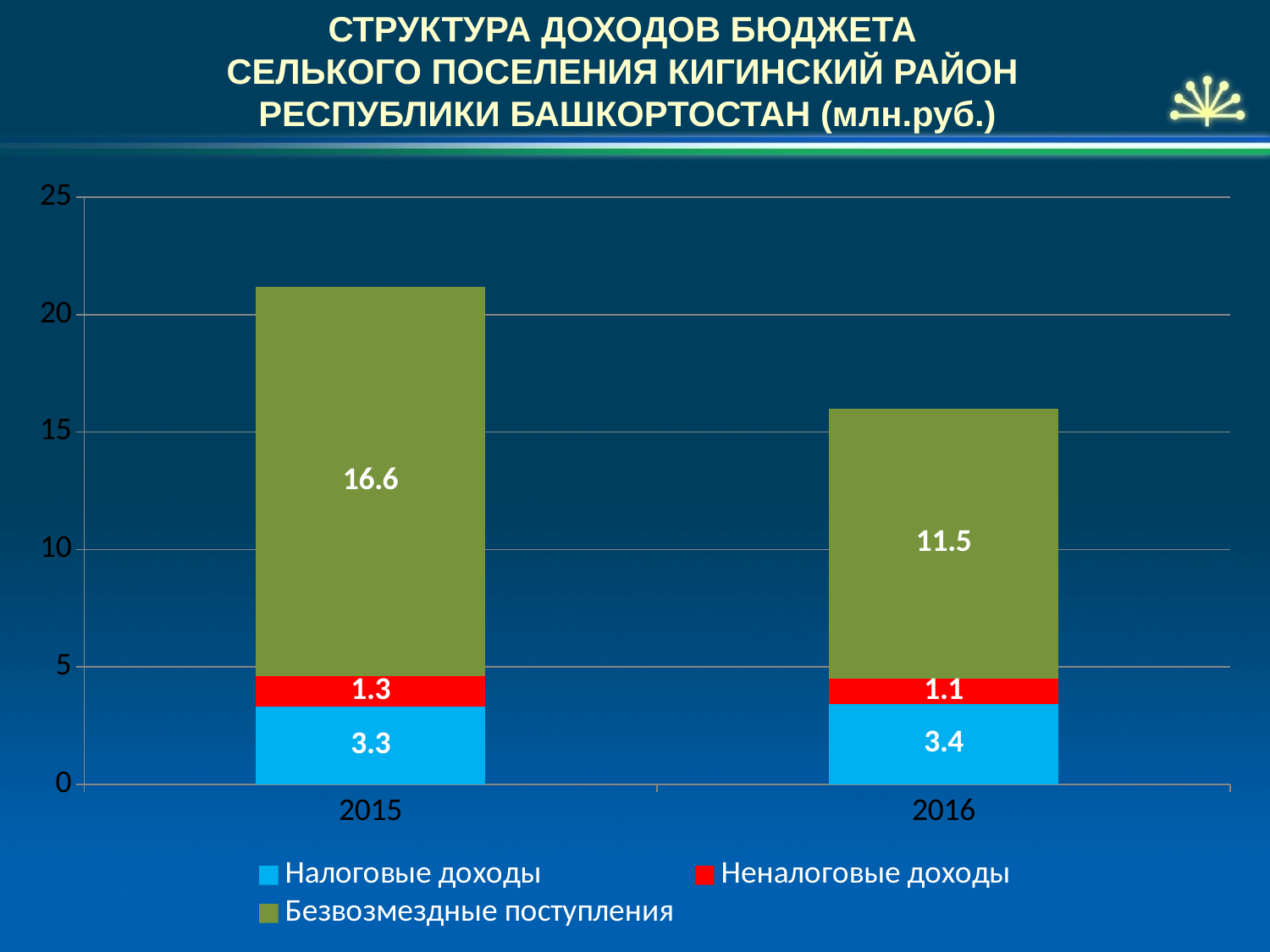
What type of chart is shown on the slide? Stacked bar chart What is the value of Безвозмездные поступления for 2015? 16.6 How many years (categories) are shown on the x axis? 2 Does the total for 2015 rise or fall compared with 2016? Falls Which year has the higher value for Неналоговые доходы, 2015 or 2016? 2015 What is the value of Неналоговые доходы for 2015? 1.3 What is the value of Налоговые доходы for 2016? 3.4 Which colour represents Налоговые доходы in the chart? Blue How many series does the legend list? 3 What is the difference between Безвозмездные поступления in 2015 and 2016? 5.1 What is the total of the stacked bar for 2016? 16.0 What is the total of the stacked bar for 2015? 21.2